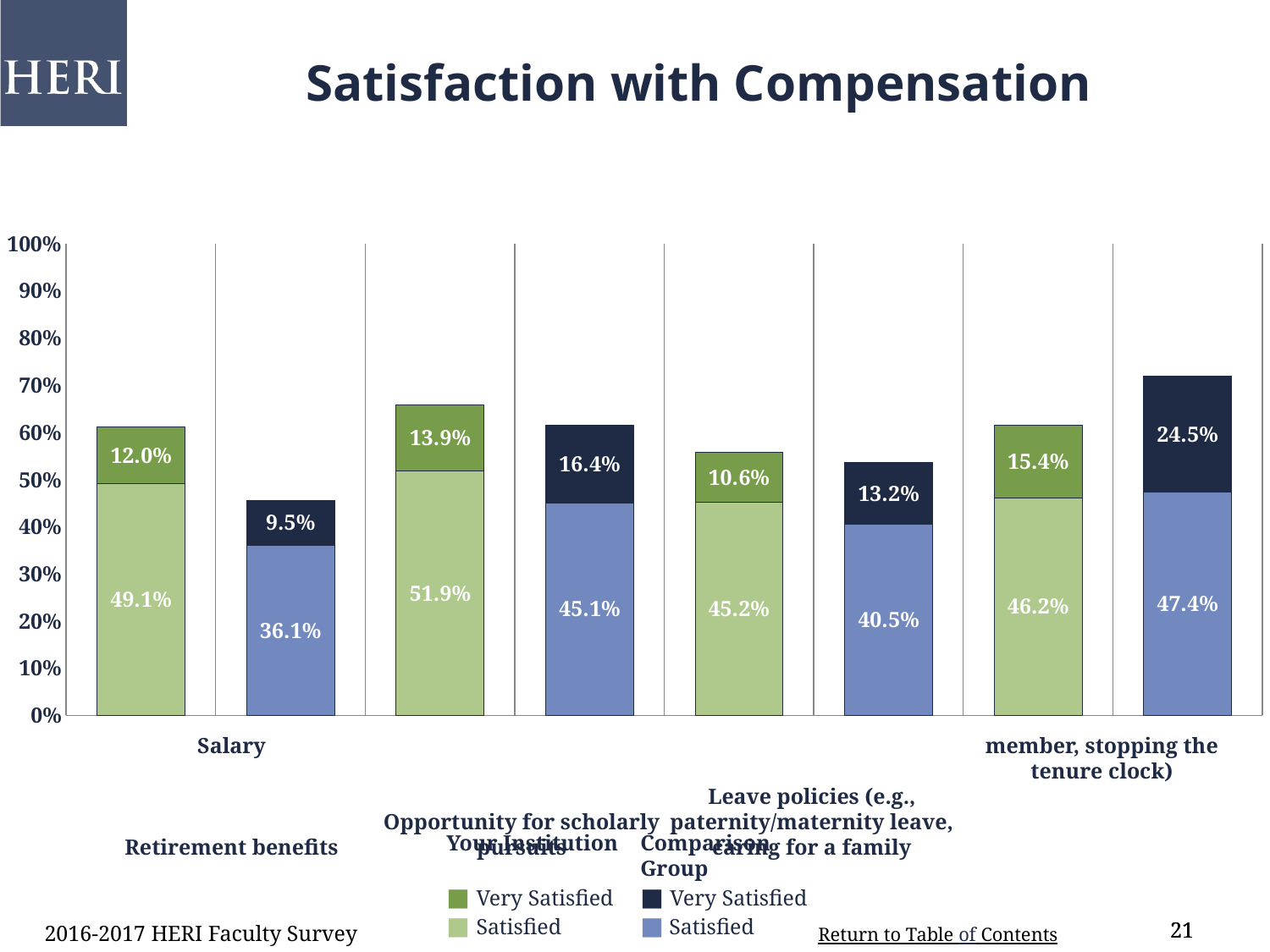
What percentage of Your Institution faculty are Satisfied with Opportunity for scholarly pursuits? 45.2% Among the Comparison Group Satisfied values, which category has the lowest percentage? Salary What is the difference between the Your Institution and Comparison Group Satisfied percentages for Salary? 13.0% What is the total of the Comparison Group stacked bar for Leave policies (Satisfied plus Very Satisfied)? 71.9% What percentage of the Comparison Group is Very Satisfied with Leave policies? 24.5% Which is larger: the Comparison Group Very Satisfied percentage for Retirement benefits or for Opportunity for scholarly pursuits? Retirement benefits What is the total of the Your Institution stacked bar for Salary (Satisfied plus Very Satisfied)? 61.1% What percentage of Your Institution faculty are Very Satisfied with Salary? 12.0% How many entries does the chart legend list? 4 What type of chart is shown on the slide? Stacked bar chart Among the Comparison Group Very Satisfied values, which category has the highest percentage? Leave policies What percentage of the Comparison Group is Satisfied with Retirement benefits? 45.1%